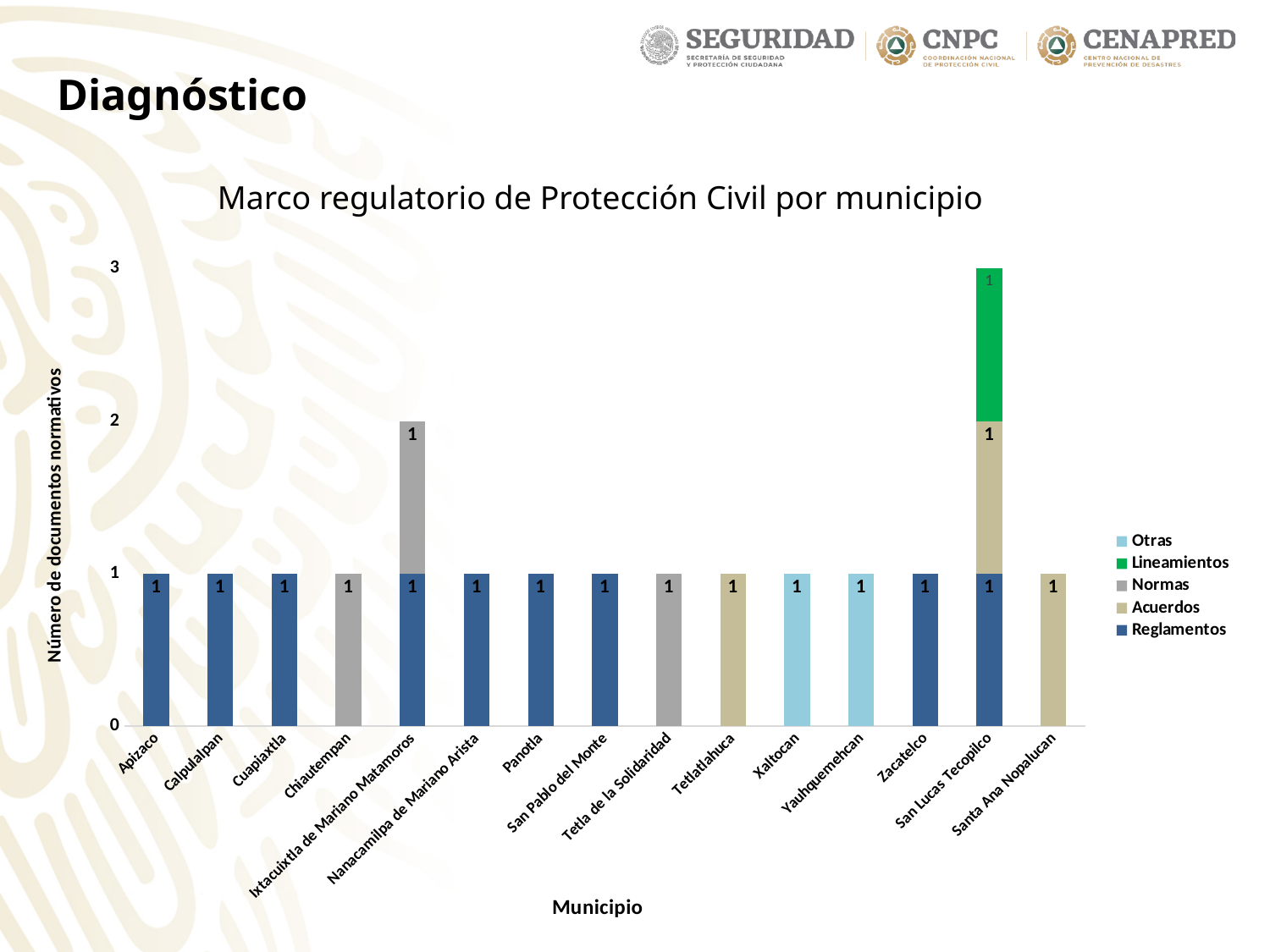
Which municipality has the highest total number of normative documents? San Lucas Tecopilco What is the difference between the total for San Lucas Tecopilco and the total for Apizaco? 2 What is the title of the chart? Marco regulatorio de Protección Civil por municipio How many municipalities are shown on the x axis? 15 What is the value of Lineamientos for San Lucas Tecopilco? 1 What type of chart is shown on the slide? Stacked bar chart What is the total number of normative documents for San Lucas Tecopilco? 3 How many series does the legend list? 5 What is the total number of normative documents for Ixtacuixtla de Mariano Matamoros? 2 What is the value of Normas for Chiautempan? 1 Which has a larger total, Ixtacuixtla de Mariano Matamoros or Zacatelco? Ixtacuixtla de Mariano Matamoros Which series does the bar for Xaltocan belong to? Otras